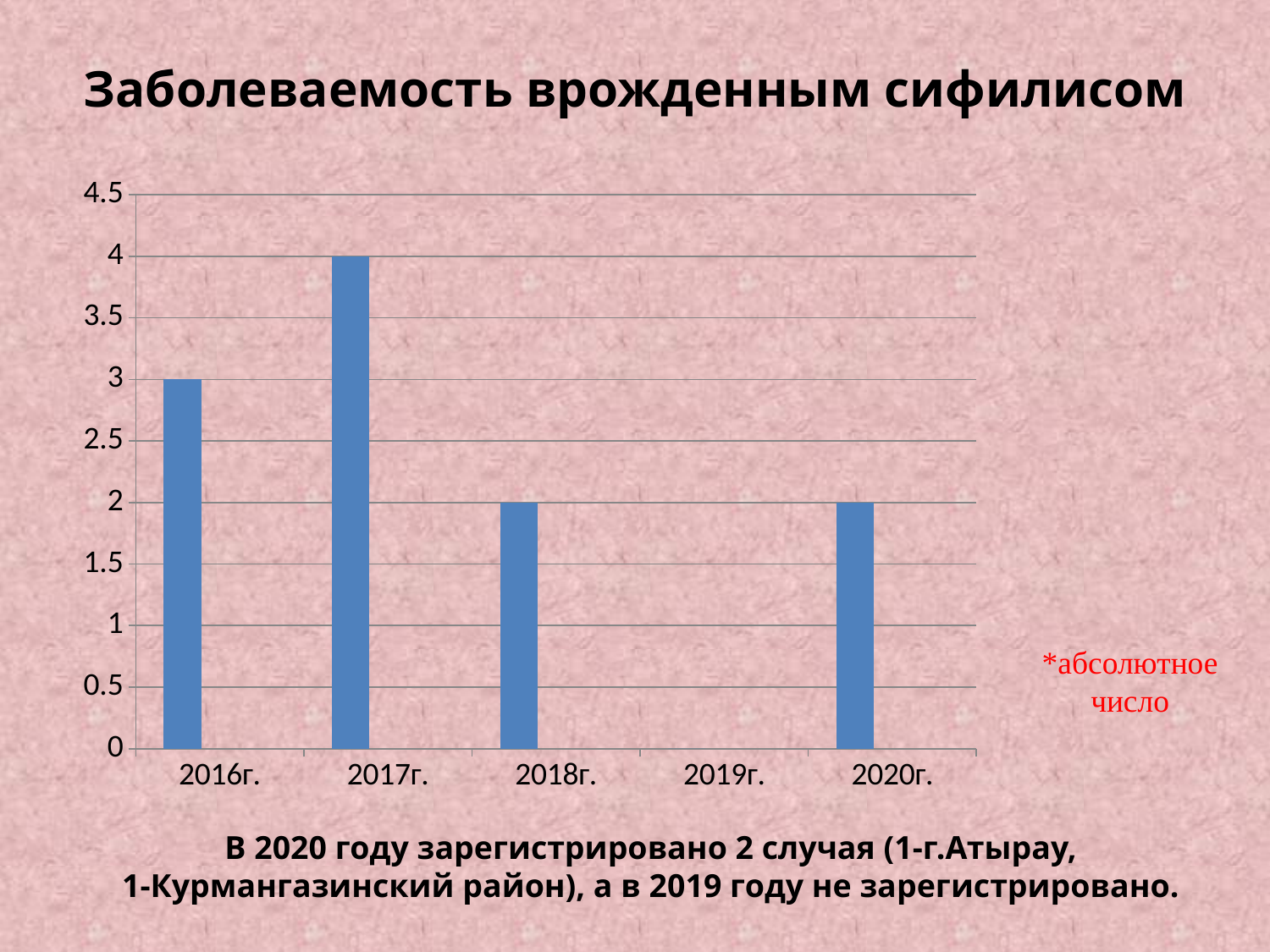
What type of chart is shown on the slide? bar chart What is the difference between the values for 2017г. and 2016г.? 1 Which year has the lowest value? 2019г. How many years are shown on the x axis? 5 What is the value for 2018г.? 2 What is the value for 2017г.? 4 What is the value for 2019г.? 0 Which is larger, the value for 2016г. or the value for 2018г.? 2016г. Which year has the highest value? 2017г. What is the title of the chart? Заболеваемость врожденным сифилисом What is the value for 2020г.? 2 What is the value for 2016г.? 3